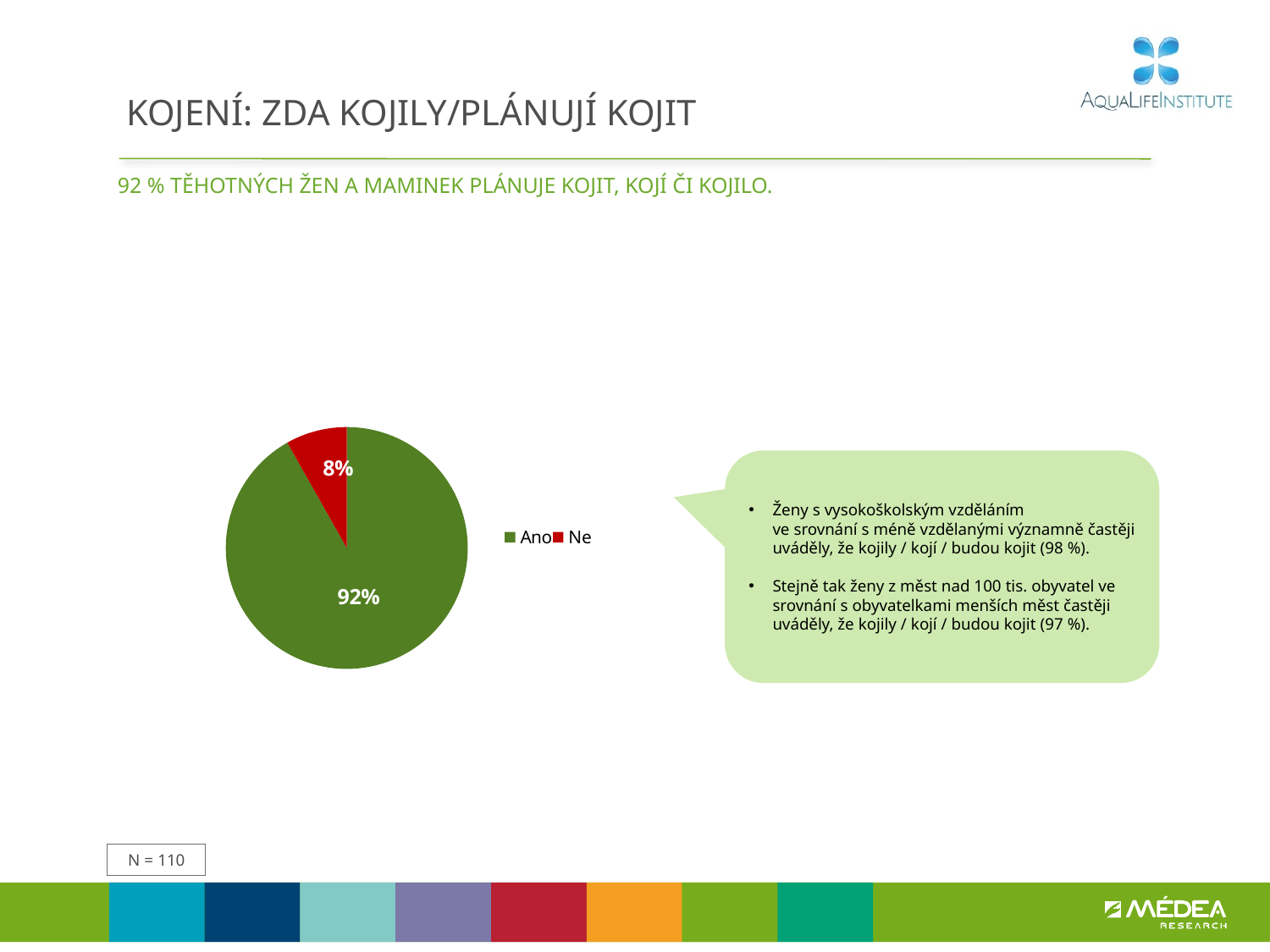
What kind of chart is shown on the slide? pie chart Which is larger, the "Ano" slice or the "Ne" slice? Ano What share of the pie does the "Ne" slice represent? 8% What is the total of the two slices shown in the pie chart? 100% Which slice of the pie chart is the largest? Ano What is the difference in percentage points between the "Ano" and "Ne" slices? 84 Which slice of the pie chart is the smallest? Ne What colour is the "Ano" slice in the pie chart? green What share of the pie does the "Ano" slice represent? 92% How many entries does the legend of the pie chart list? 2 What colour is the "Ne" slice in the pie chart? red How many slices does the pie chart have? 2